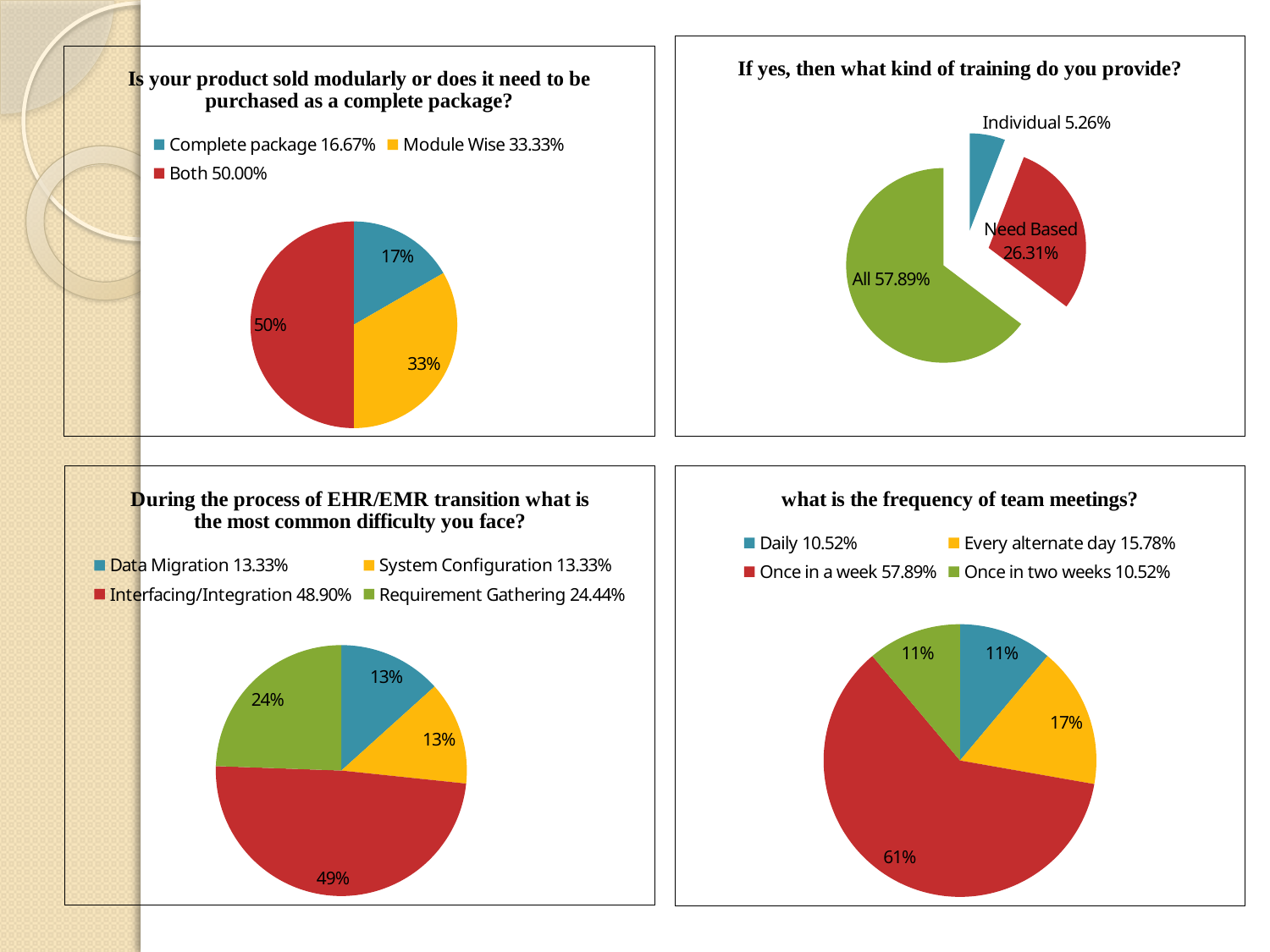
In the top-right chart titled 'If yes, then what kind of training do you provide?', what percentage is shown for Need Based? 26.31% In the top-left chart about whether the product is sold modularly, what percentage does the legend give for Module Wise? 33.33% In the bottom-right chart about the frequency of team meetings, which category has the largest share? Once in a week In the top-right chart titled 'If yes, then what kind of training do you provide?', how many slices does the pie have? 3 In the top-right chart titled 'If yes, then what kind of training do you provide?', which category has the smallest share? Individual What type of chart is used in the bottom-right chart about the frequency of team meetings? Pie chart In the top-left chart about whether the product is sold modularly, which category has the largest share? Both In the bottom-left chart about the most common difficulty during EHR/EMR transition, which is larger, Requirement Gathering or Data Migration? Requirement Gathering In the bottom-right chart about the frequency of team meetings, what percentage does the legend give for Every alternate day? 15.78% In the bottom-left chart about the most common difficulty during EHR/EMR transition, what percentage does the legend give for Interfacing/Integration? 48.90% In the top-left chart about whether the product is sold modularly, what is the data label shown on the Complete package slice? 17% In the bottom-left chart about the most common difficulty during EHR/EMR transition, how many categories does the legend list? 4